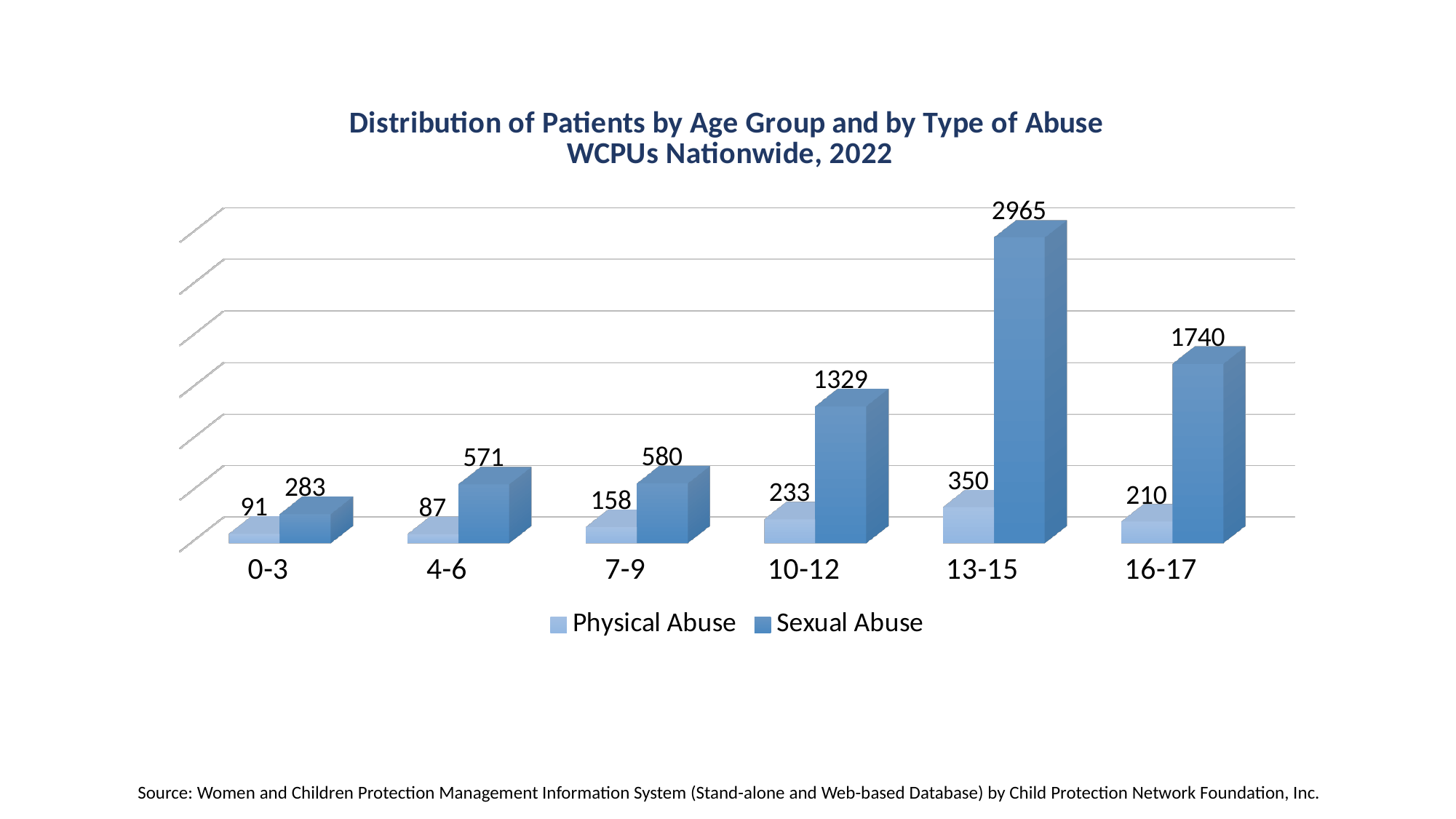
Which age group has the highest Sexual Abuse value? 13-15 How many series does the legend list? 2 What is the value for Sexual Abuse in the 13-15 age group? 2965 What is the total of Physical Abuse and Sexual Abuse for the 10-12 age group? 1562 Which is larger: the Physical Abuse value for 10-12 or for 16-17? 10-12 What kind of chart is shown on the slide? Bar chart How many age groups are shown on the x axis? 6 Which age group has the lowest Physical Abuse value? 4-6 What are the two series listed in the legend? Physical Abuse and Sexual Abuse What is the value for Sexual Abuse in the 0-3 age group? 283 What is the value for Physical Abuse in the 7-9 age group? 158 What is the difference between the Sexual Abuse values for the 13-15 and 16-17 age groups? 1225